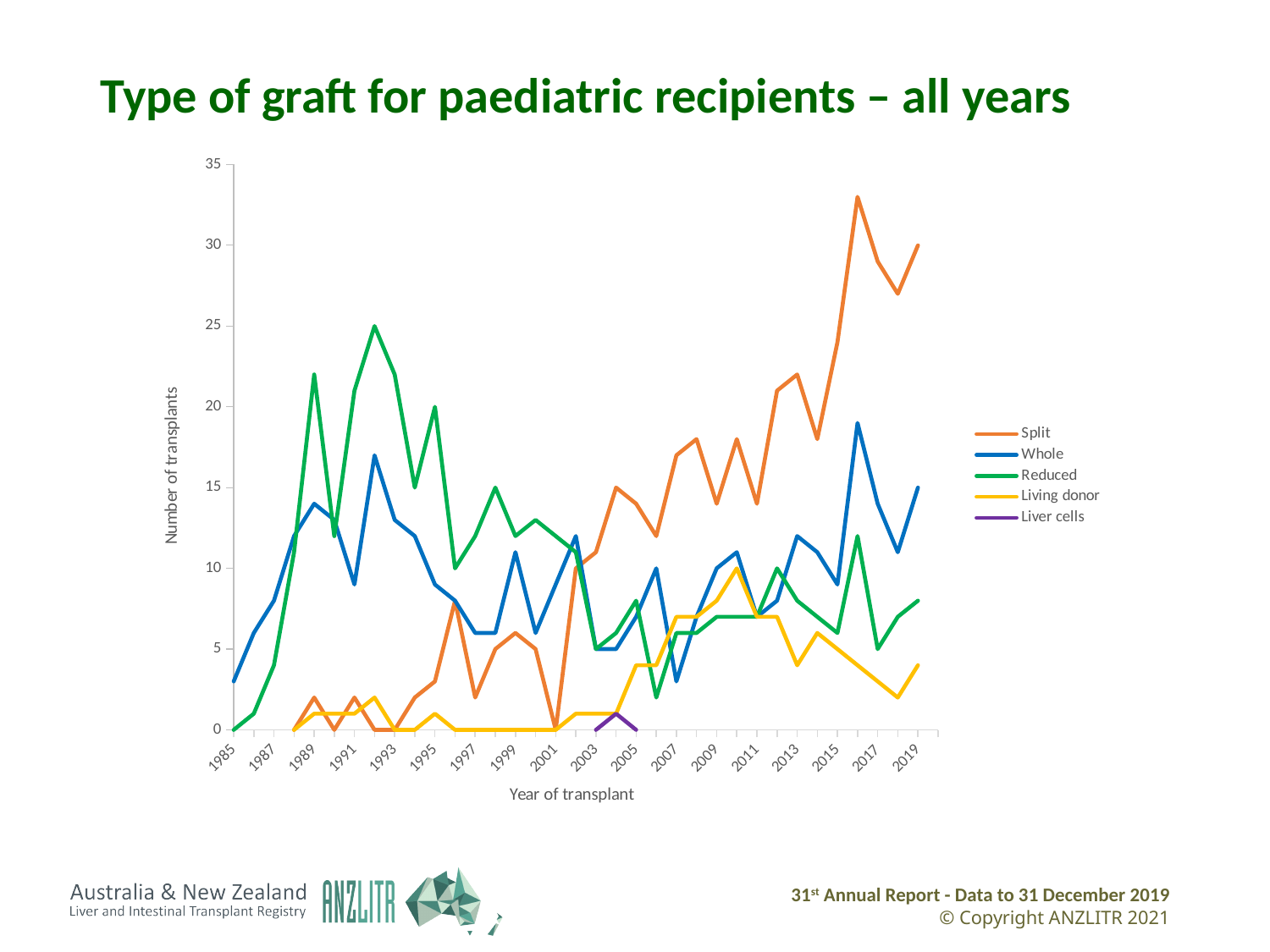
In 2019, which series has the larger value, Split or Whole? Split Is the value for Living donor in 2010 greater or less than 5? greater What is the title of the chart? Type of graft for paediatric recipients – all years How many series does the legend list? 5 Which series reaches the highest value anywhere on the chart? Split Does the Reduced series rise or fall from 1992 to 1994? fall What kind of chart is shown on the slide? line chart Is the value for Split in 2016 greater or less than 30? greater What is the label on the vertical axis? Number of transplants Is the value for Whole in 2016 greater or less than 15? greater In 1992, which series has the larger value, Reduced or Whole? Reduced